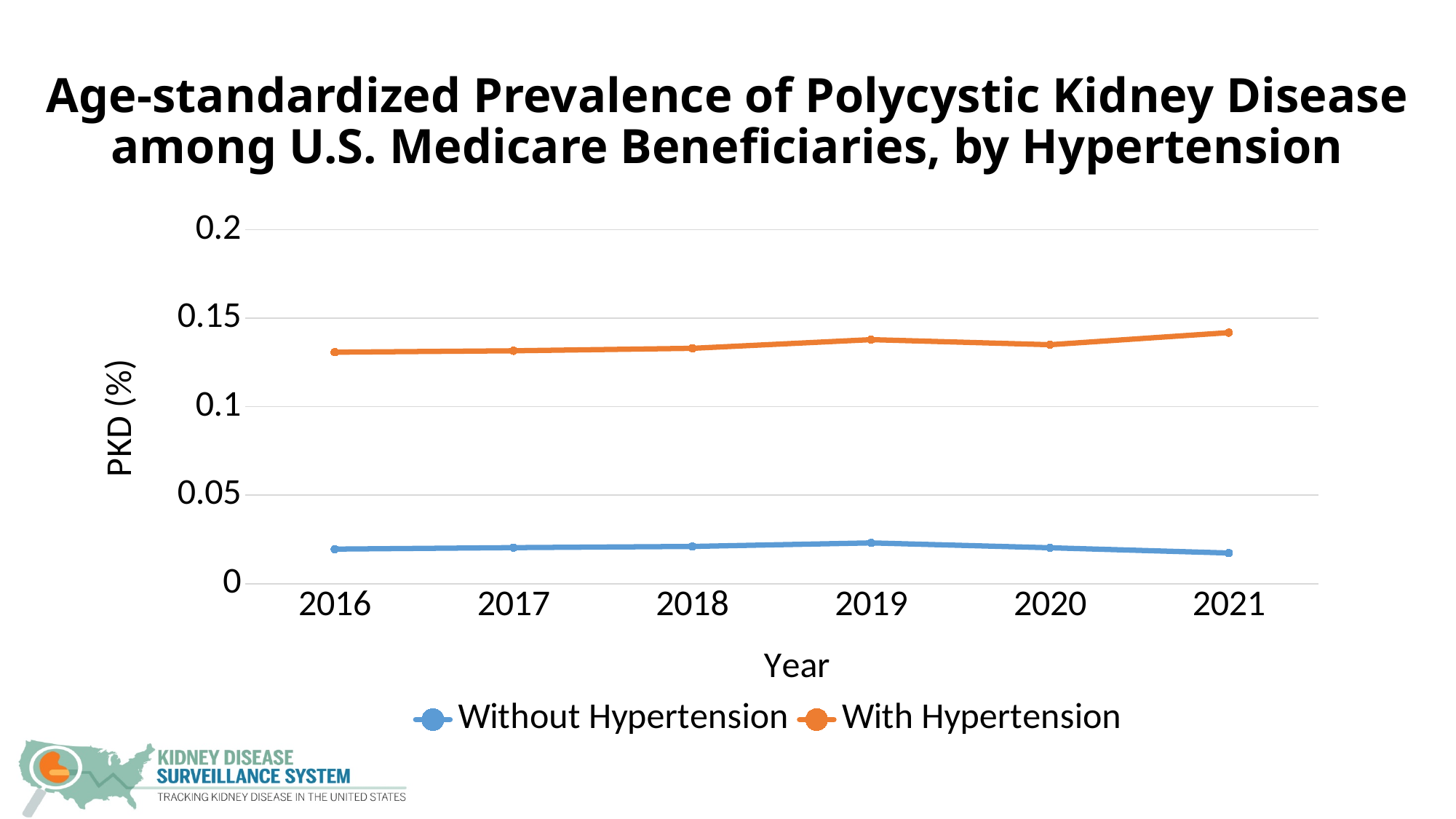
What colour is the line for Without Hypertension? Blue In 2021, which series has the larger value, With Hypertension or Without Hypertension? With Hypertension In which year is the Without Hypertension value highest? 2019 Is the value for Without Hypertension in 2019 greater or less than 0.05? less What kind of chart is shown on the slide? Line chart Is the value for With Hypertension in 2016 greater or less than 0.1? greater How many series does the legend list? 2 How many years are plotted along the x axis? 6 In which year is the Without Hypertension value lowest? 2021 What is the label on the y axis? PKD (%) Is the value for With Hypertension in 2021 greater or less than 0.15? less Does the With Hypertension line generally rise or fall from 2016 to 2021? Rise